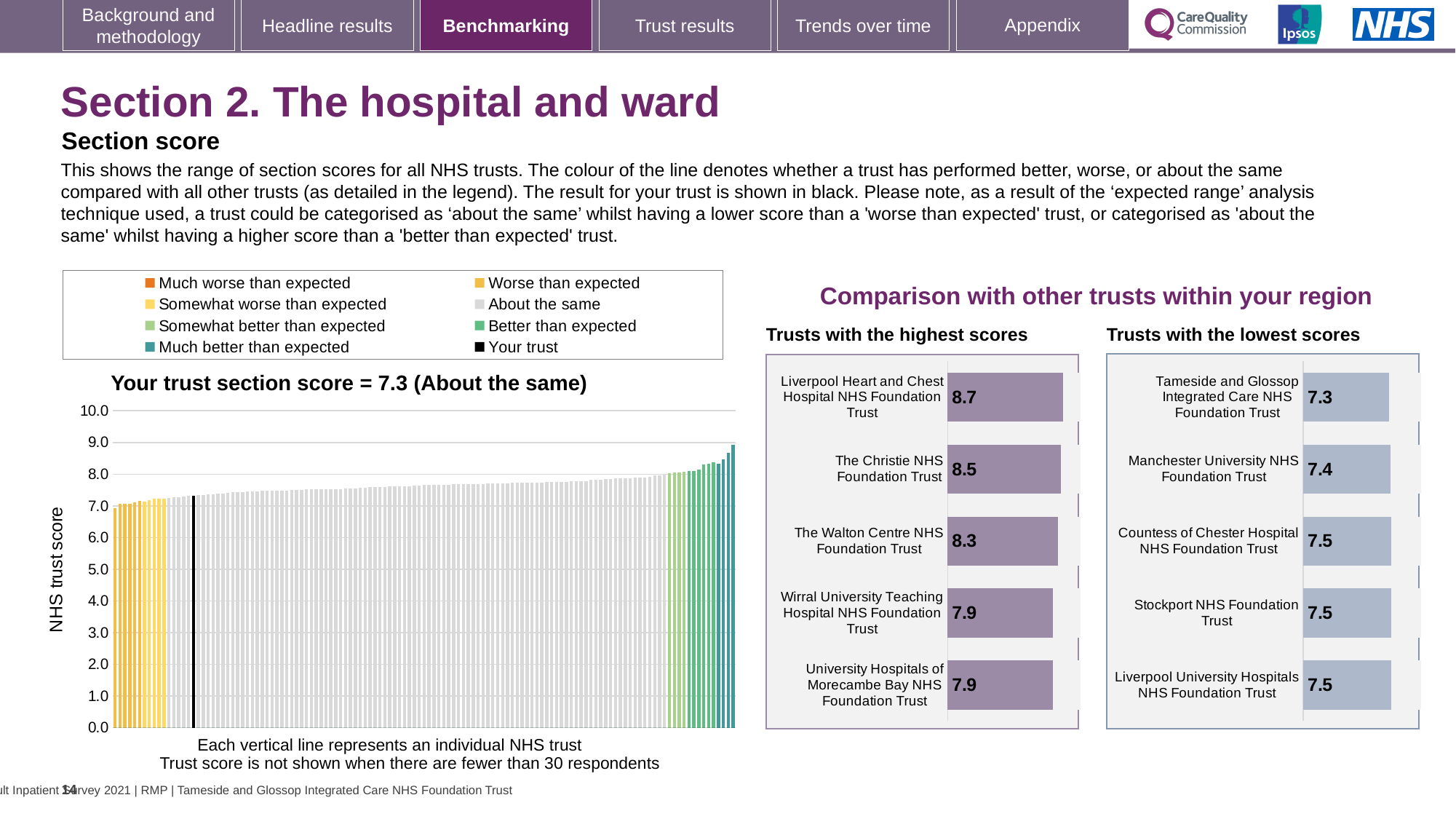
What kind of chart is the main chart on the left showing all NHS trusts? Bar chart In the 'Trusts with the lowest scores' chart, which trust has the lowest score? Tameside and Glossop Integrated Care NHS Foundation Trust In the 'Trusts with the lowest scores' chart, what is the difference between the scores of Stockport NHS Foundation Trust and Tameside and Glossop Integrated Care NHS Foundation Trust? 0.2 In the main chart on the left, do the trust scores rise or fall from left to right along the x axis? Rise In the 'Trusts with the highest scores' chart, which has a higher score: The Christie NHS Foundation Trust or Wirral University Teaching Hospital NHS Foundation Trust? The Christie NHS Foundation Trust In the 'Trusts with the highest scores' chart, what is the score for Liverpool Heart and Chest Hospital NHS Foundation Trust? 8.7 In the 'Trusts with the lowest scores' chart, what is the score for Manchester University NHS Foundation Trust? 7.4 In the 'Trusts with the highest scores' chart, which trust has the highest score? Liverpool Heart and Chest Hospital NHS Foundation Trust How many trusts are listed in the 'Trusts with the lowest scores' chart? 5 In the main chart on the left, what is the section score for your trust? 7.3 In the 'Trusts with the highest scores' chart, what is the difference between the scores of Liverpool Heart and Chest Hospital NHS Foundation Trust and The Christie NHS Foundation Trust? 0.2 In the 'Trusts with the highest scores' chart, what is the score for The Walton Centre NHS Foundation Trust? 8.3